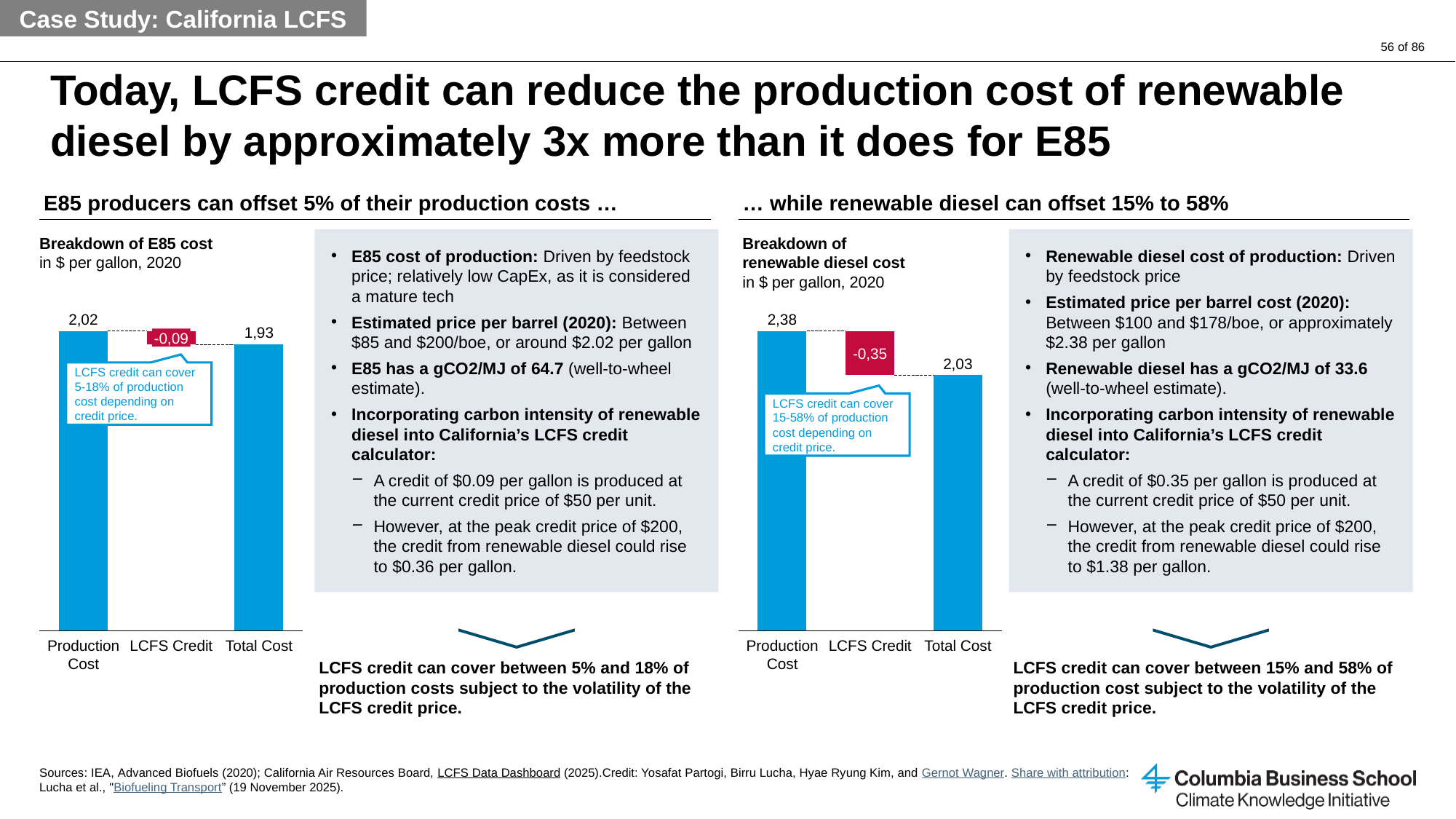
In the 'Breakdown of E85 cost' chart, what is the value for Production Cost? 2,02 What kind of chart is the 'Breakdown of renewable diesel cost' chart? Bar chart In the 'Breakdown of renewable diesel cost' chart, what is the value for Total Cost? 2,03 In the 'Breakdown of E85 cost' chart, what is the difference between Production Cost and Total Cost? 0,09 In the 'Breakdown of E85 cost' chart, what unit are the values expressed in, according to the subtitle? $ per gallon In the 'Breakdown of renewable diesel cost' chart, what is the difference between Production Cost and Total Cost? 0,35 In the 'Breakdown of E85 cost' chart, what is the value for Total Cost? 1,93 In the 'Breakdown of E85 cost' chart, what is the value for LCFS Credit? -0,09 Which chart has the higher Production Cost value, 'Breakdown of E85 cost' or 'Breakdown of renewable diesel cost'? Breakdown of renewable diesel cost How many categories are shown on the x axis of the 'Breakdown of E85 cost' chart? 3 In the 'Breakdown of renewable diesel cost' chart, what is the value for LCFS Credit? -0,35 In the 'Breakdown of renewable diesel cost' chart, what is the value for Production Cost? 2,38